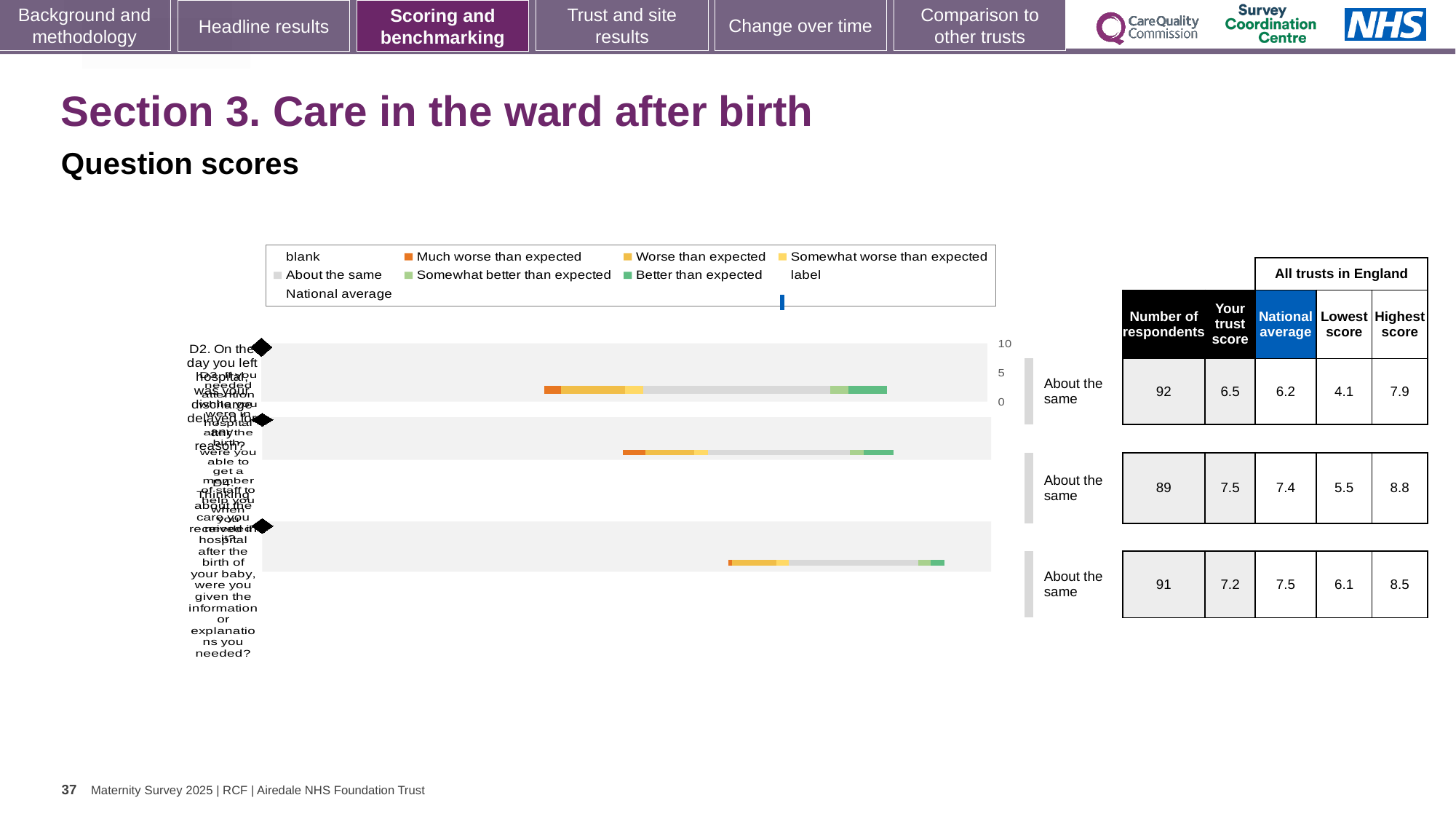
What kind of chart is shown on the slide? bar chart How many bars (question rows) are plotted in the chart? 3 What is the first legend entry shown in the chart legend? blank What colour is the 'Much worse than expected' legend entry? orange In the table next to the chart, what is the number of respondents in the first row? 92 What benchmark label is shown beside each of the three bars? About the same In the table next to the chart, what is the national average in the third row? 7.5 In the table next to the chart, which row has the lowest 'Lowest score' value? the first row (4.1) In the table next to the chart, what is the 'Your trust score' value in the second row? 7.5 In the table next to the chart, is the trust score in the first row larger or smaller than the national average in that row? larger In the table next to the chart, what is the difference between the highest score and the lowest score in the first row? 3.8 In the table next to the chart, what is the highest score in the second row? 8.8